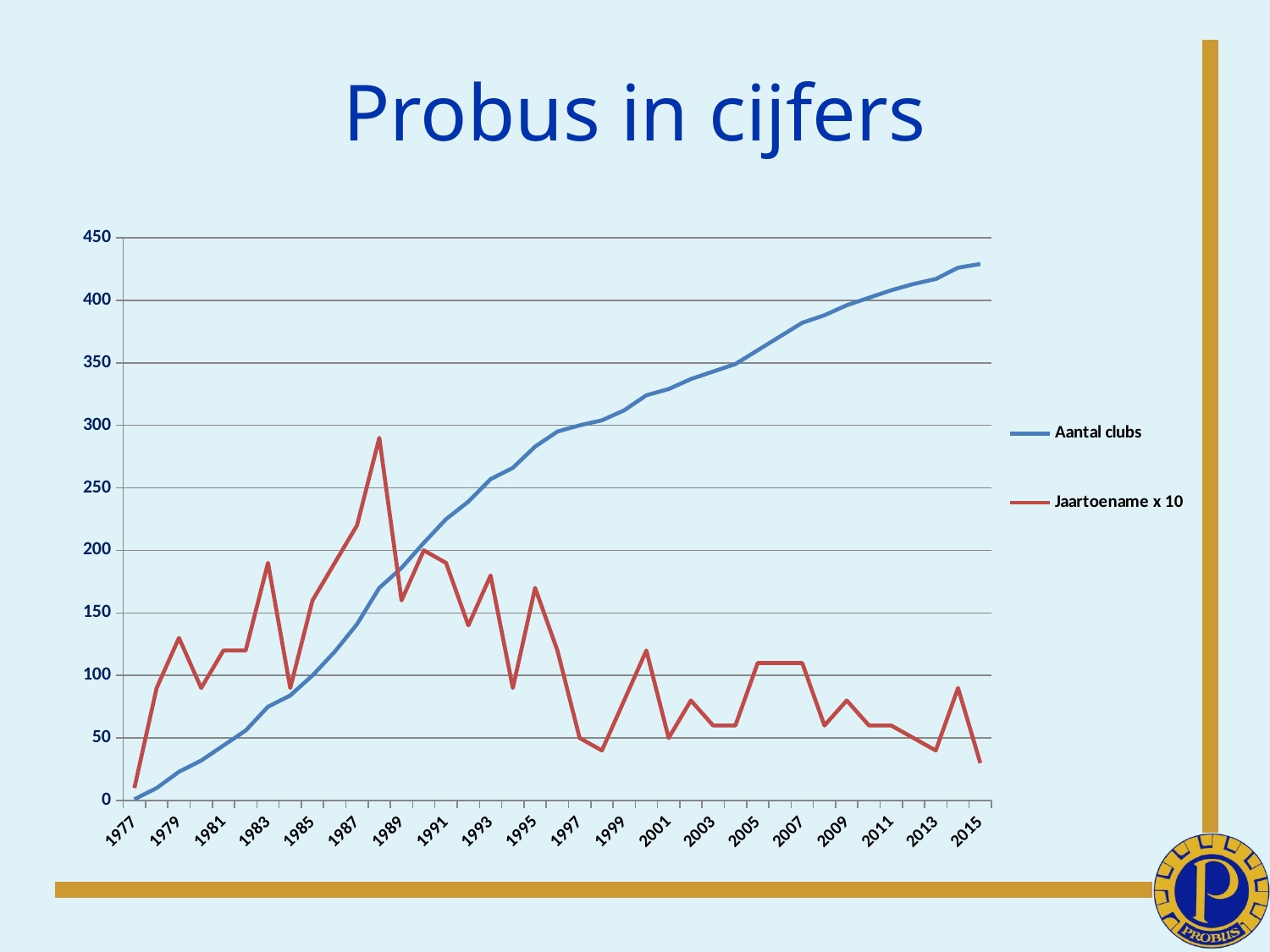
How many series does the legend list? 2 Is the value for Jaartoename x 10 in 1988 greater or less than 250? greater Is the value for Aantal clubs in 2015 greater or less than 400? greater Is the value for Jaartoename x 10 in 2015 greater or less than 50? less Which series is drawn in red? Jaartoename x 10 In which year is the Aantal clubs series at its highest? 2015 In which year is the Jaartoename x 10 series at its lowest value? 1977 What is the title of the slide chart? Probus in cijfers Does the Aantal clubs series rise or fall from 1977 to 2015? rise In 2005, which series has the higher value, Aantal clubs or Jaartoename x 10? Aantal clubs In which year does the Jaartoename x 10 series reach its highest value? 1988 What kind of chart is shown on the slide? line chart